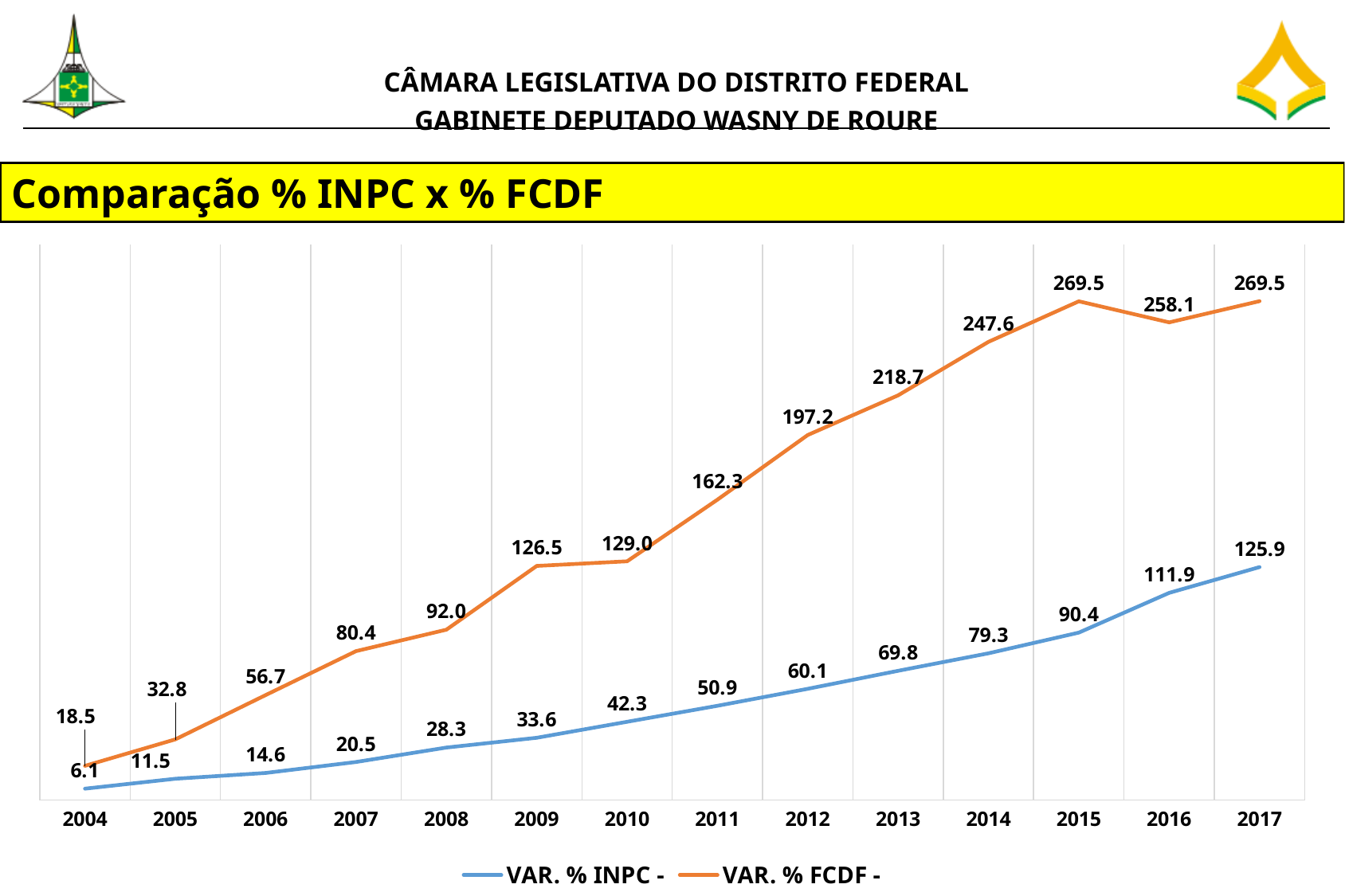
How many years are plotted along the x axis? 14 Which series has the larger value in 2009, VAR. % INPC or VAR. % FCDF? VAR. % FCDF How many series does the legend list? 2 What is the highest value reached by VAR. % FCDF? 269.5 What is the value of VAR. % FCDF in 2012? 197.2 What type of chart is shown on the slide? Line chart What is the value of VAR. % INPC in 2010? 42.3 Does VAR. % INPC rise or fall from 2004 to 2017? Rise What is the value of VAR. % FCDF in 2016? 258.1 In which year is VAR. % INPC at its lowest? 2004 What is the difference between VAR. % FCDF and VAR. % INPC in 2017? 143.6 What is the title of the chart? Comparação % INPC x % FCDF